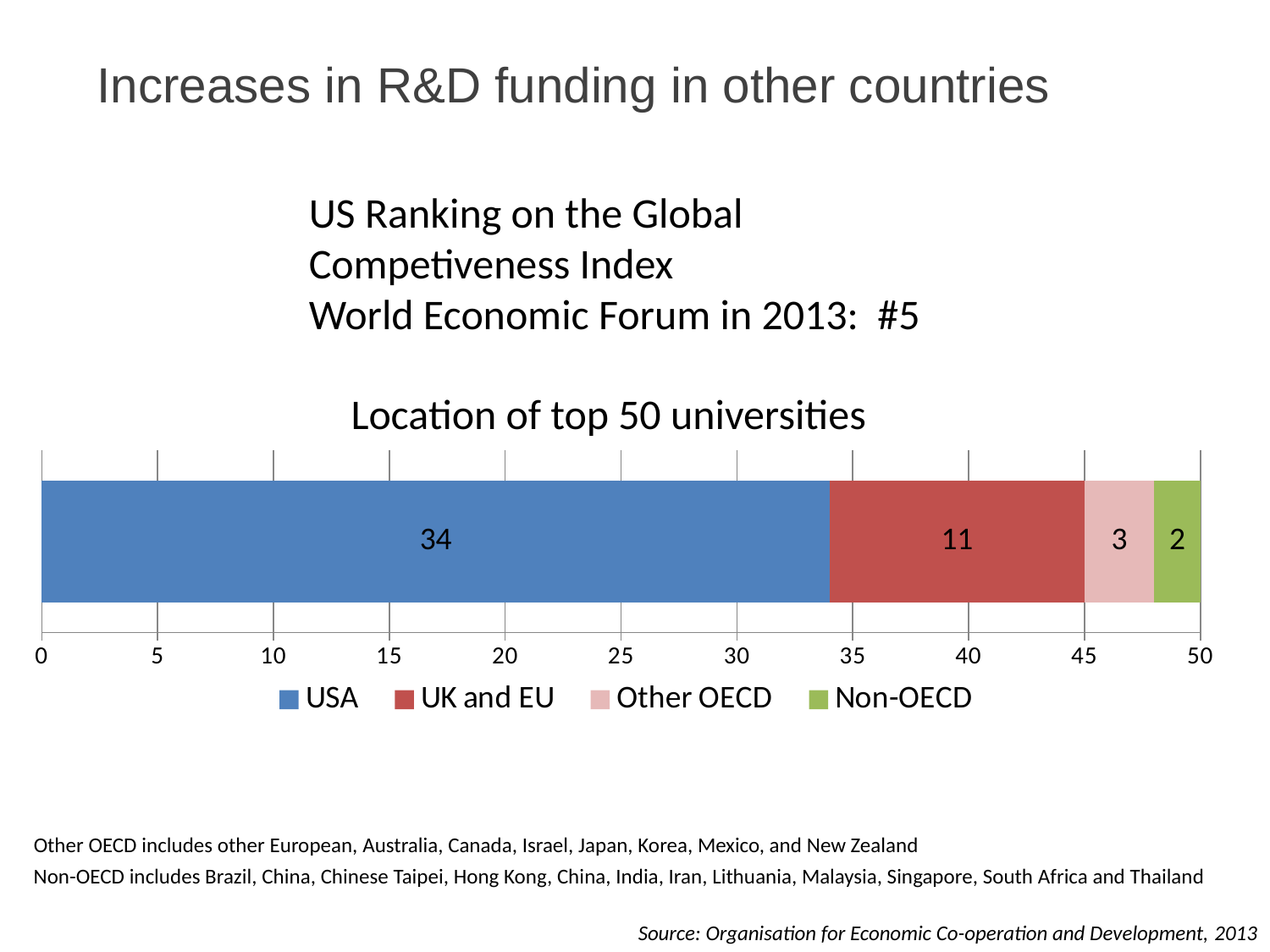
What is the difference between the USA value and the UK and EU value in the 'Location of top 50 universities' chart? 23 Which series has the largest value in the 'Location of top 50 universities' chart? USA What colour represents USA in the 'Location of top 50 universities' chart? Blue Which series has the smallest value in the 'Location of top 50 universities' chart? Non-OECD What kind of chart is the 'Location of top 50 universities' chart? Stacked bar chart What is the value for Non-OECD in the 'Location of top 50 universities' chart? 2 What is the total of the stacked bar in the 'Location of top 50 universities' chart? 50 What is the value for USA in the 'Location of top 50 universities' chart? 34 What is the value for Other OECD in the 'Location of top 50 universities' chart? 3 Which is larger in the 'Location of top 50 universities' chart, Other OECD or Non-OECD? Other OECD How many series does the legend list in the 'Location of top 50 universities' chart? 4 What is the value for UK and EU in the 'Location of top 50 universities' chart? 11